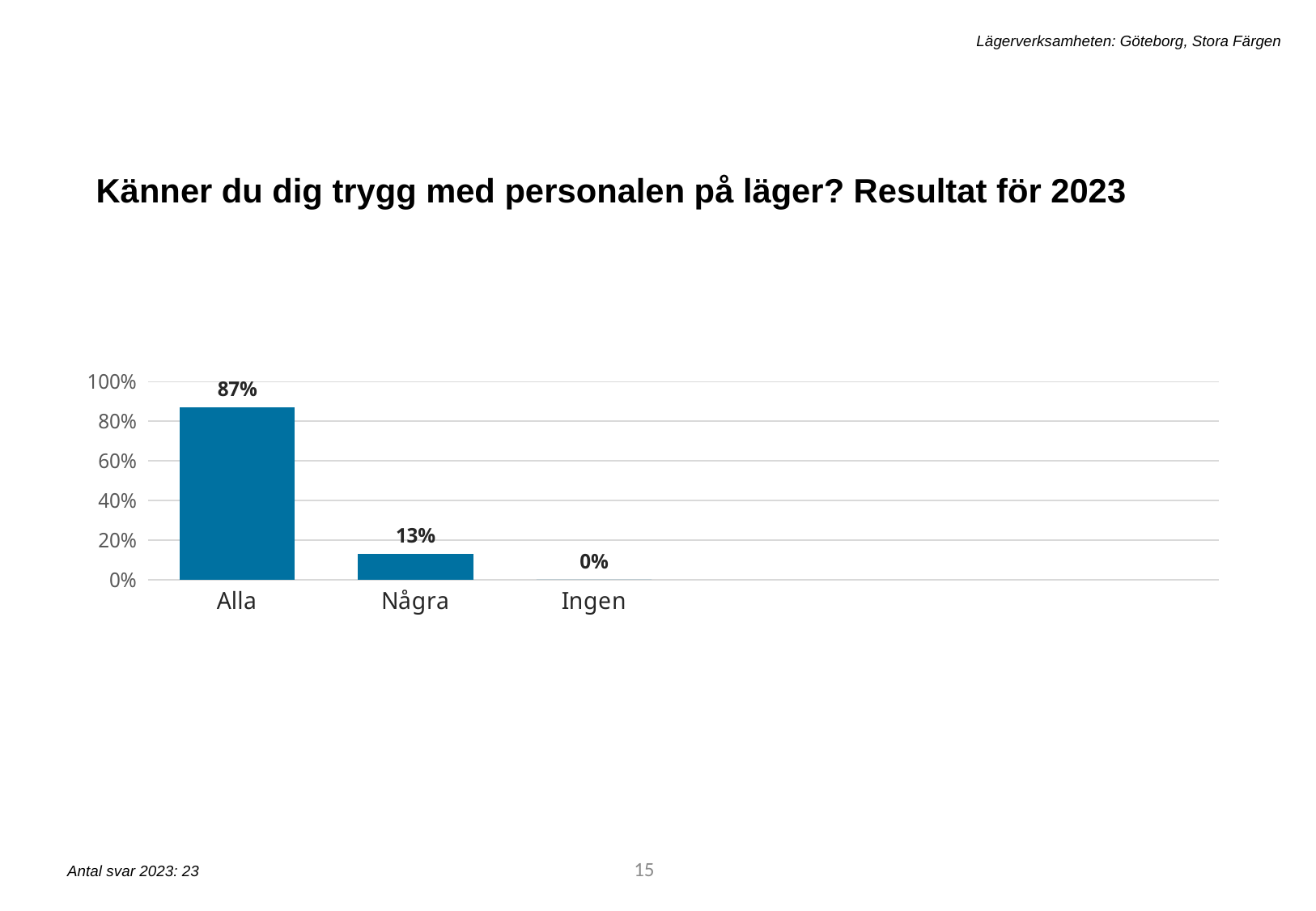
What is the title of the chart on the slide? Känner du dig trygg med personalen på läger? Resultat för 2023 Is the value for Alla greater or less than 80%? greater Which category has the highest value? Alla How many categories are shown on the x axis? 3 Which category has the lowest value? Ingen Which is larger, the value for Alla or the value for Några? Alla Is the value for Några greater or less than 20%? less What is the value for Några? 13% What kind of chart is shown on the slide? bar chart What is the value for Ingen? 0% What is the difference between the values for Alla and Några? 74% What is the value for Alla? 87%